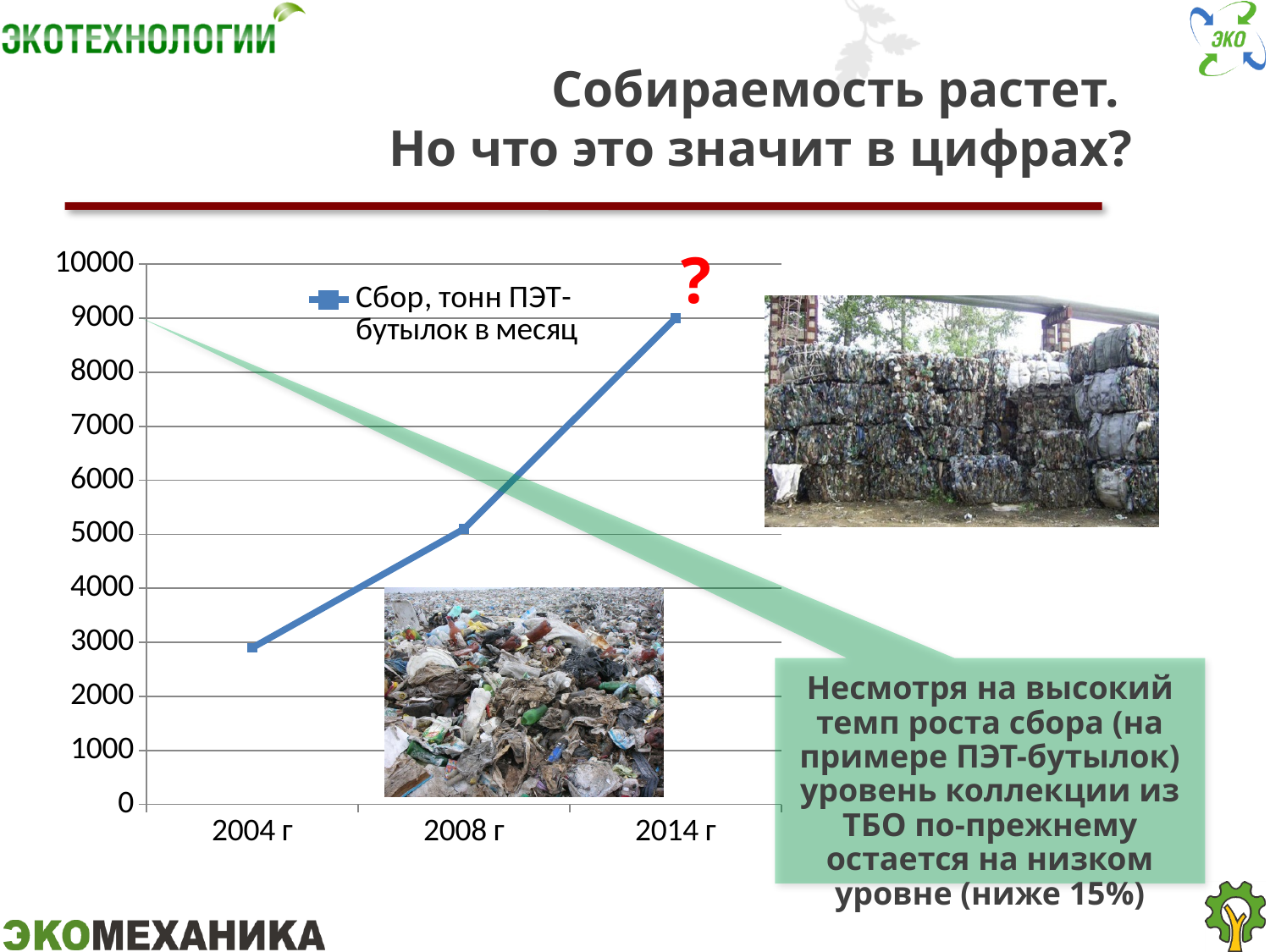
What is the maximum value shown on the chart's vertical axis? 10000 Which is larger, the value for 2008 г or the value for 2004 г? 2008 г Which year has the lowest value on the chart? 2004 г Is the value for 2008 г greater or less than 4000? greater Do the values rise or fall from 2004 г to 2014 г? rise What is the name of the series shown in the chart legend? Сбор, тонн ПЭТ-бутылок в месяц Which year has the highest value on the chart? 2014 г Is the value for 2014 г greater or less than 8000? greater What kind of chart is shown on the slide? line chart How many series does the chart legend list? 1 How many data points are plotted on the chart? 3